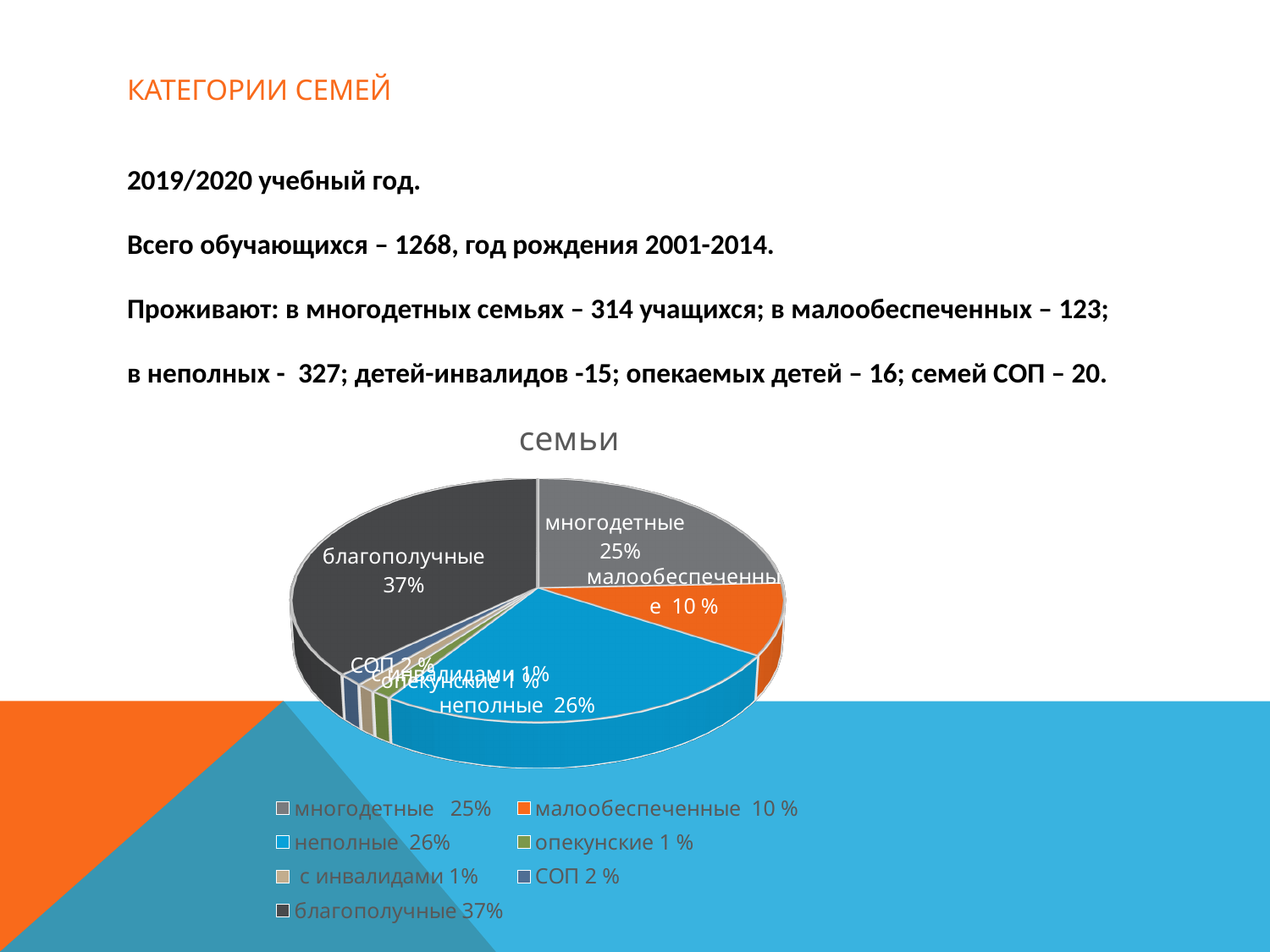
What colour is the малообеспеченные slice? orange What percentage is shown for неполные? 26% What percentage is shown for многодетные? 25% What percentage is shown for СОП? 2 % What share of the pie is the благополучные slice? 37% How many categories does the pie chart have? 7 Which slice is larger, благополучные or неполные? благополучные Which category has the largest slice of the pie? благополучные What percentage is shown for малообеспеченные? 10 % What is the title of the chart? семьи What kind of chart is shown on the slide? pie chart What is the difference in percentage points between благополучные and многодетные? 12